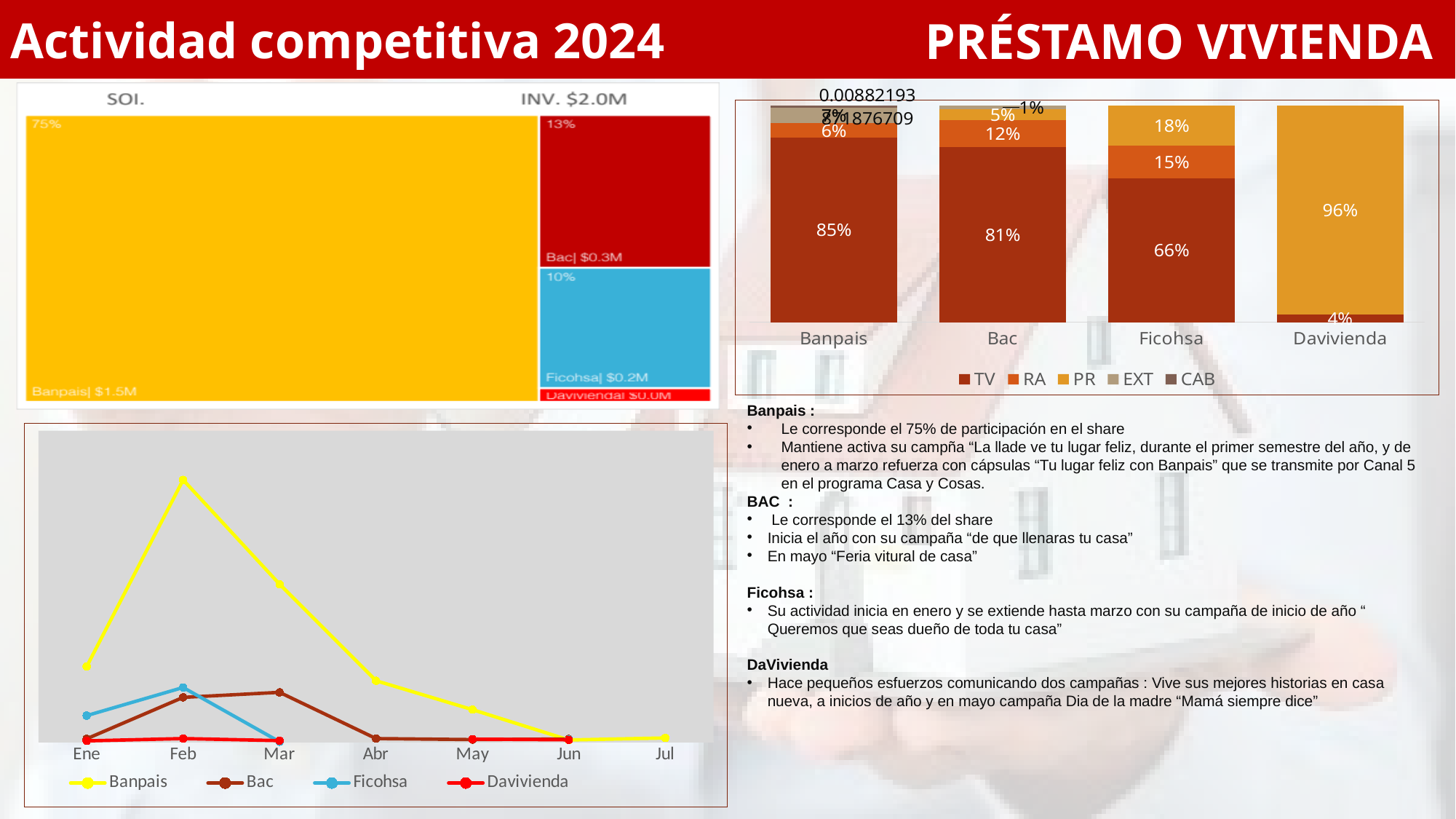
In the treemap chart at the top left, what share does Banpais hold? 75% In the stacked bar chart at the top right, which brand has the lowest TV share? Davivienda In the line chart at the bottom left, in which month does Banpais reach its peak? Feb In the stacked bar chart at the top right, what is the RA share for Ficohsa? 15% In the line chart at the bottom left, how many months are shown on the x axis? 7 In the treemap chart at the top left, which brand has the largest share? Banpais In the treemap chart at the top left, what investment amount is shown for Ficohsa? $0.2M In the stacked bar chart at the top right, what is the TV share for Banpais? 85% In the stacked bar chart at the top right, how many series does the legend list? 5 In the treemap chart at the top left, what is the difference in share between Bac and Ficohsa? 3% In the stacked bar chart at the top right, what is the PR share for Davivienda? 96% In the treemap chart at the top left, what investment amount is shown for Bac? $0.3M